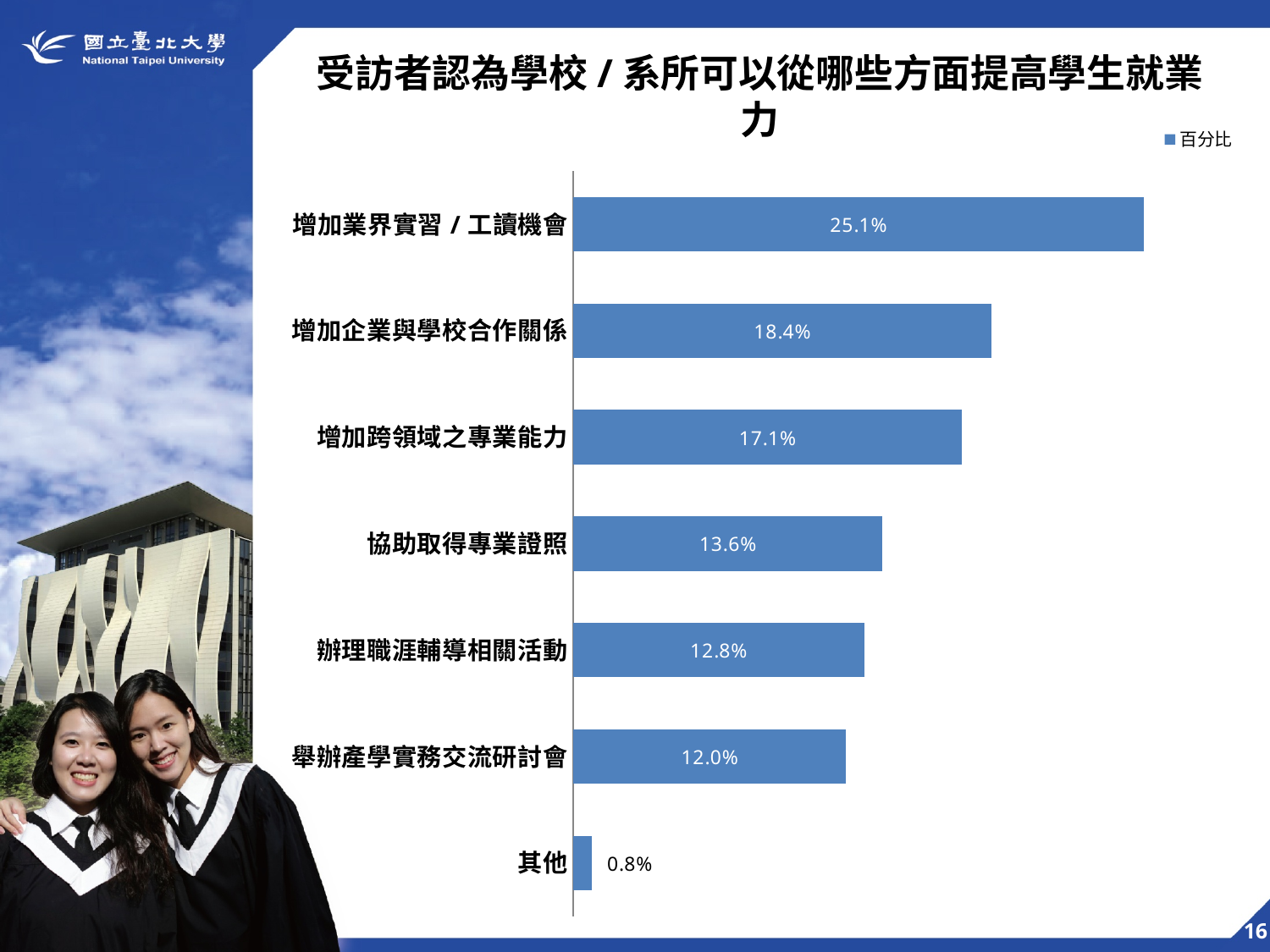
What is the difference between 增加業界實習／工讀機會 and 舉辦產學實務交流研討會? 13.1% How many series does the legend list? 1 Which category has the lowest value? 其他 What kind of chart is shown on the slide? Bar chart Which category has the highest value? 增加業界實習／工讀機會 How many categories are shown in the chart? 7 What is the legend entry shown on the chart? 百分比 What is the value for 增加業界實習／工讀機會? 25.1% What is the value for 協助取得專業證照? 13.6% What is the value for 其他? 0.8% Which is larger, 辦理職涯輔導相關活動 or 舉辦產學實務交流研討會? 辦理職涯輔導相關活動 What is the difference between 增加企業與學校合作關係 and 增加跨領域之專業能力? 1.3%